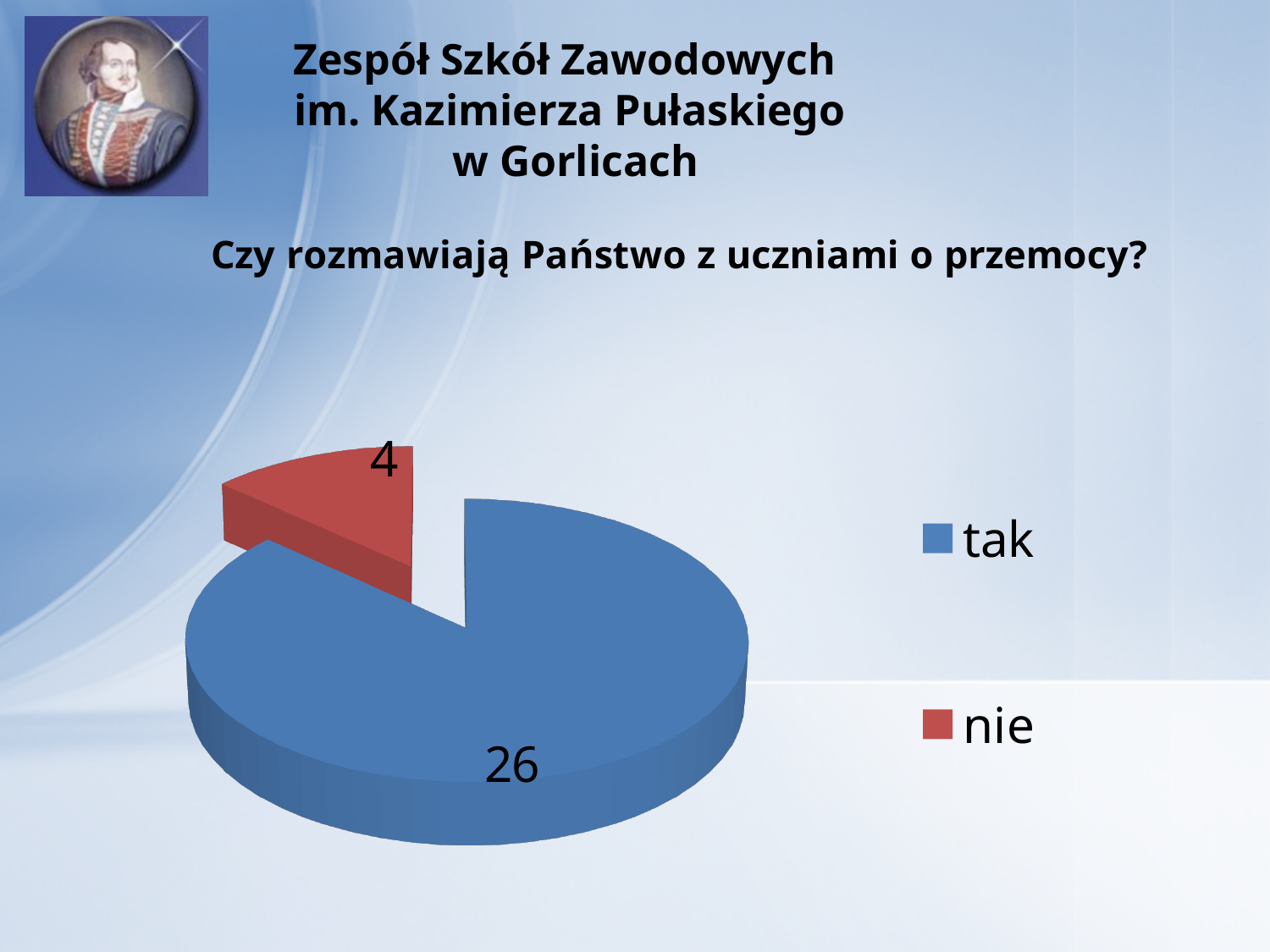
Which category has the largest slice of the pie? tak What colour is the "nie" slice in the pie chart? red Which category has the smallest slice of the pie? nie What value is shown for the "tak" slice? 26 What kind of chart is shown on the slide? pie chart What value is shown for the "nie" slice? 4 How many categories does the pie chart show? 2 Which is larger, the value for "tak" or the value for "nie"? tak What is the total of all slices in the pie chart? 30 What is the difference between the "tak" and "nie" values? 22 What share of the pie does the "nie" slice represent, as a fraction of the total? 4 out of 30 What question is the chart answering, according to the text above it? Czy rozmawiają Państwo z uczniami o przemocy?